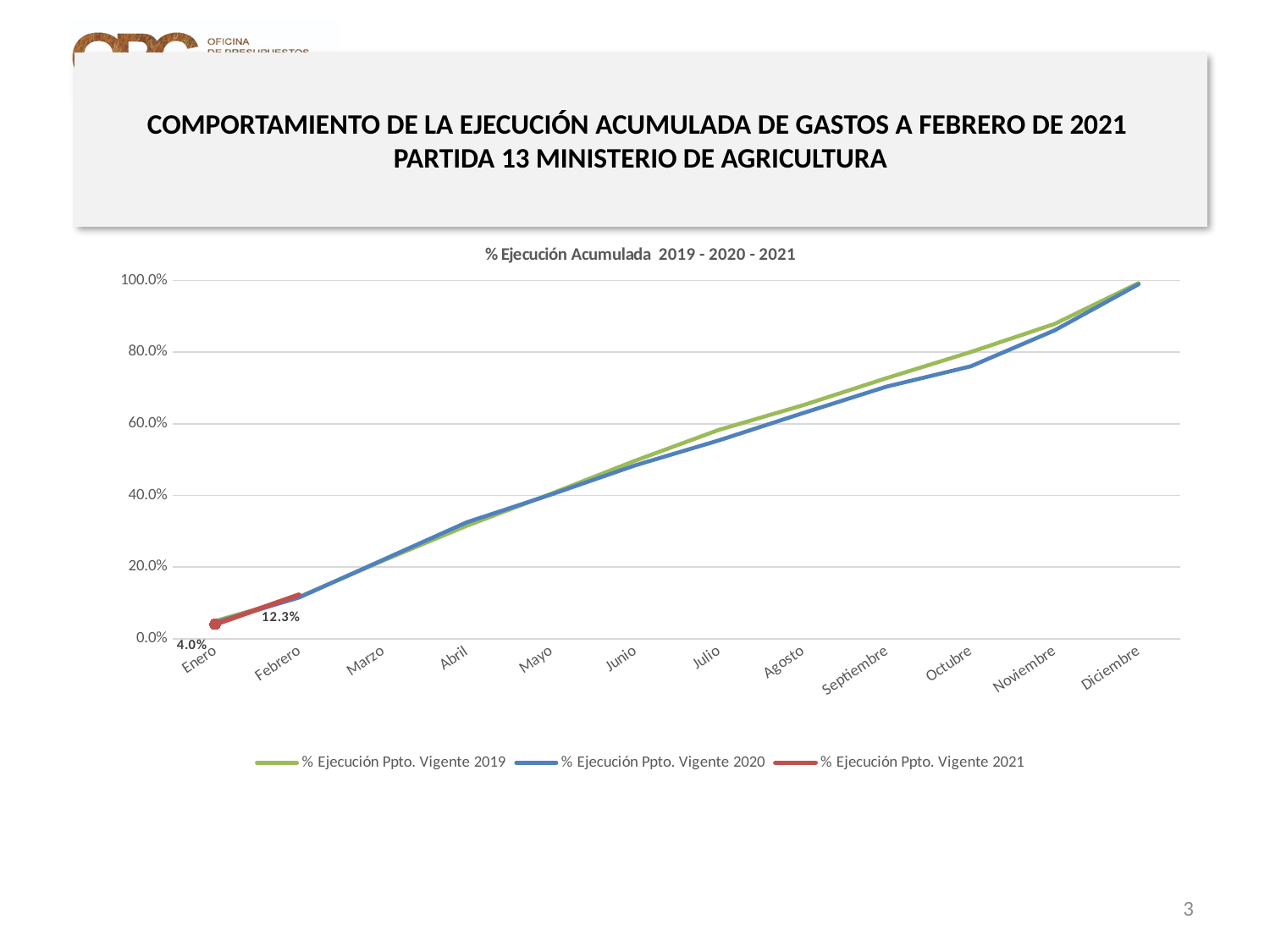
In which month does % Ejecución Ppto. Vigente 2020 reach its highest value? Diciembre What kind of chart is shown on the slide? line chart In Octubre, which series has the higher value: % Ejecución Ppto. Vigente 2019 or % Ejecución Ppto. Vigente 2020? % Ejecución Ppto. Vigente 2019 How many series does the legend list? 3 Do the values for % Ejecución Ppto. Vigente 2020 rise or fall from Enero to Diciembre? rise How many months are shown on the x axis? 12 Is the value for % Ejecución Ppto. Vigente 2020 in Octubre greater or less than 80.0%? less By how much did % Ejecución Ppto. Vigente 2021 increase from Enero to Febrero? 8.3% Is the value for % Ejecución Ppto. Vigente 2019 in Noviembre greater or less than 80.0%? greater What is the title of the chart? % Ejecución Acumulada 2019 - 2020 - 2021 What is the value for % Ejecución Ppto. Vigente 2021 in Febrero? 12.3% What is the value for % Ejecución Ppto. Vigente 2021 in Enero? 4.0%